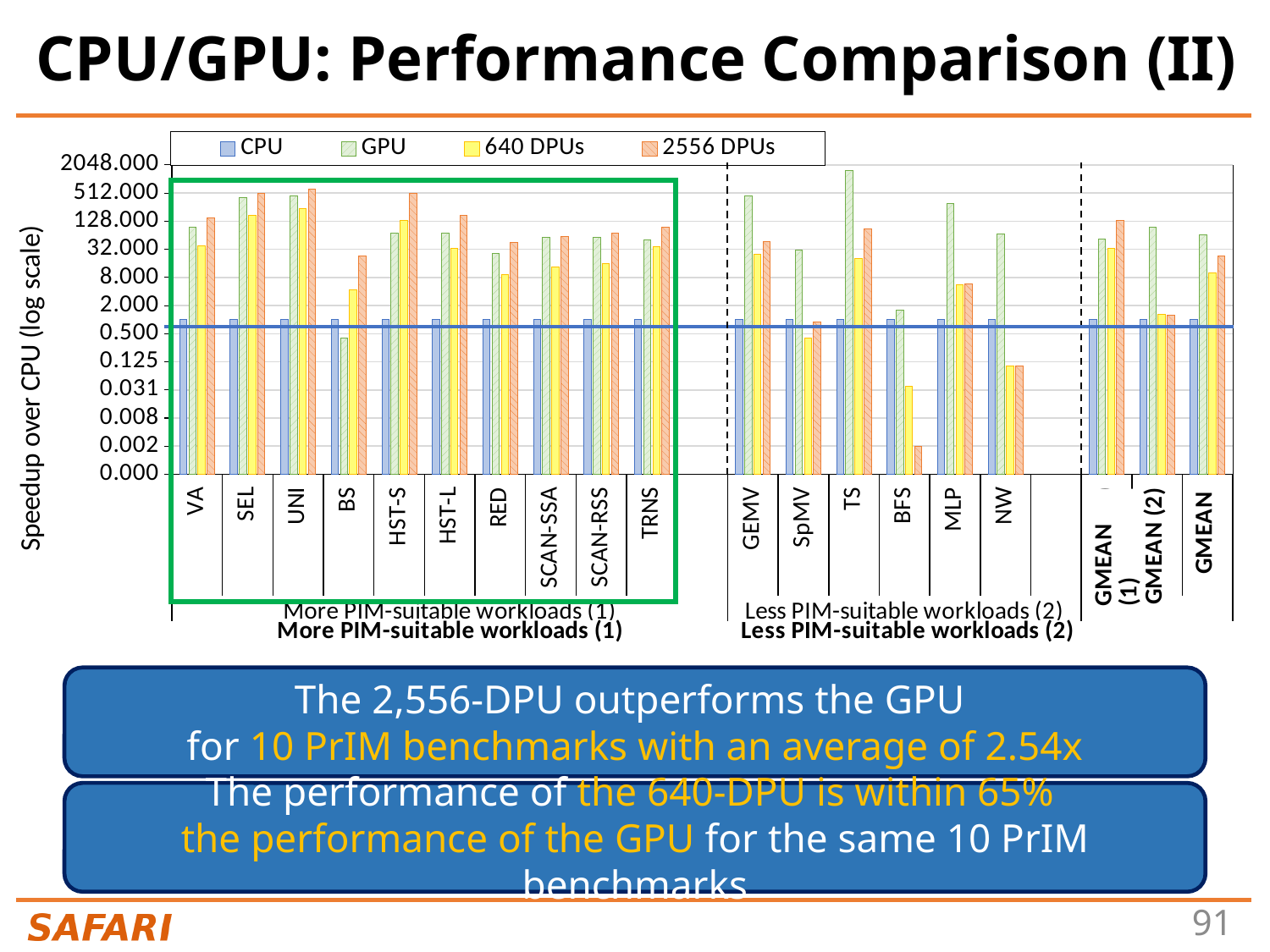
What kind of chart is shown on the slide? bar chart Which workload has the lowest 2556 DPUs bar in the chart? BFS How many series does the chart legend list? 4 Is the GPU value for TS greater or less than 512.000? greater For MLP, which is larger: the GPU value or the 2556 DPUs value? GPU For VA, which is larger: the GPU value or the 2556 DPUs value? 2556 DPUs Is the 640 DPUs value for NW greater or less than 0.500? less Which workload has the highest GPU bar in the chart? TS What is the label of the y axis of the chart? Speedup over CPU (log scale) Is the 2556 DPUs value for BFS greater or less than 0.008? less What are the series listed in the chart legend? CPU, GPU, 640 DPUs, 2556 DPUs